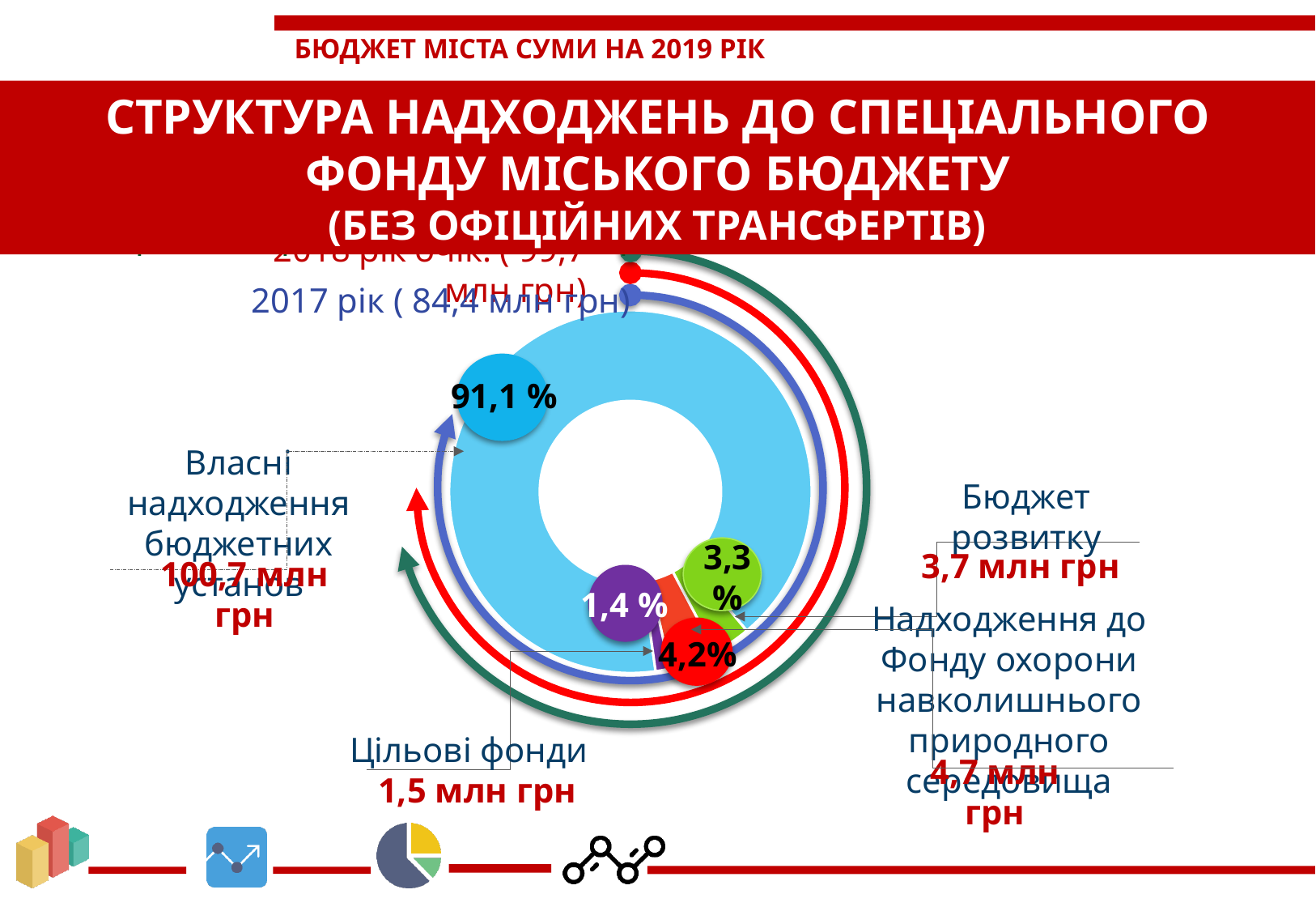
What share of the special fund revenues is Надходження до Фонду охорони навколишнього природного середовища? 4,2% What total amount is shown for 2017 рік? 84,4 млн грн Which is larger: the share of Бюджет розвитку or the share of Надходження до Фонду охорони навколишнього природного середовища? Надходження до Фонду охорони навколишнього природного середовища What share of the special fund revenues is Цільові фонди? 1,4 % Which category has the smallest share of the special fund revenues? Цільові фонди What share of the special fund revenues comes from Власні надходження бюджетних установ? 91,1 % What is the difference in percentage points between the share of Надходження до Фонду охорони навколишнього природного середовища (4,2%) and Бюджет розвитку (3,3 %)? 0,9 What share of the special fund revenues is Бюджет розвитку? 3,3 % How many categories (slices) does the doughnut chart show? 4 What amount in млн грн is shown for Цільові фонди? 1,5 млн грн What kind of chart is shown on the slide? doughnut (pie) chart Which category has the largest share of the special fund revenues? Власні надходження бюджетних установ